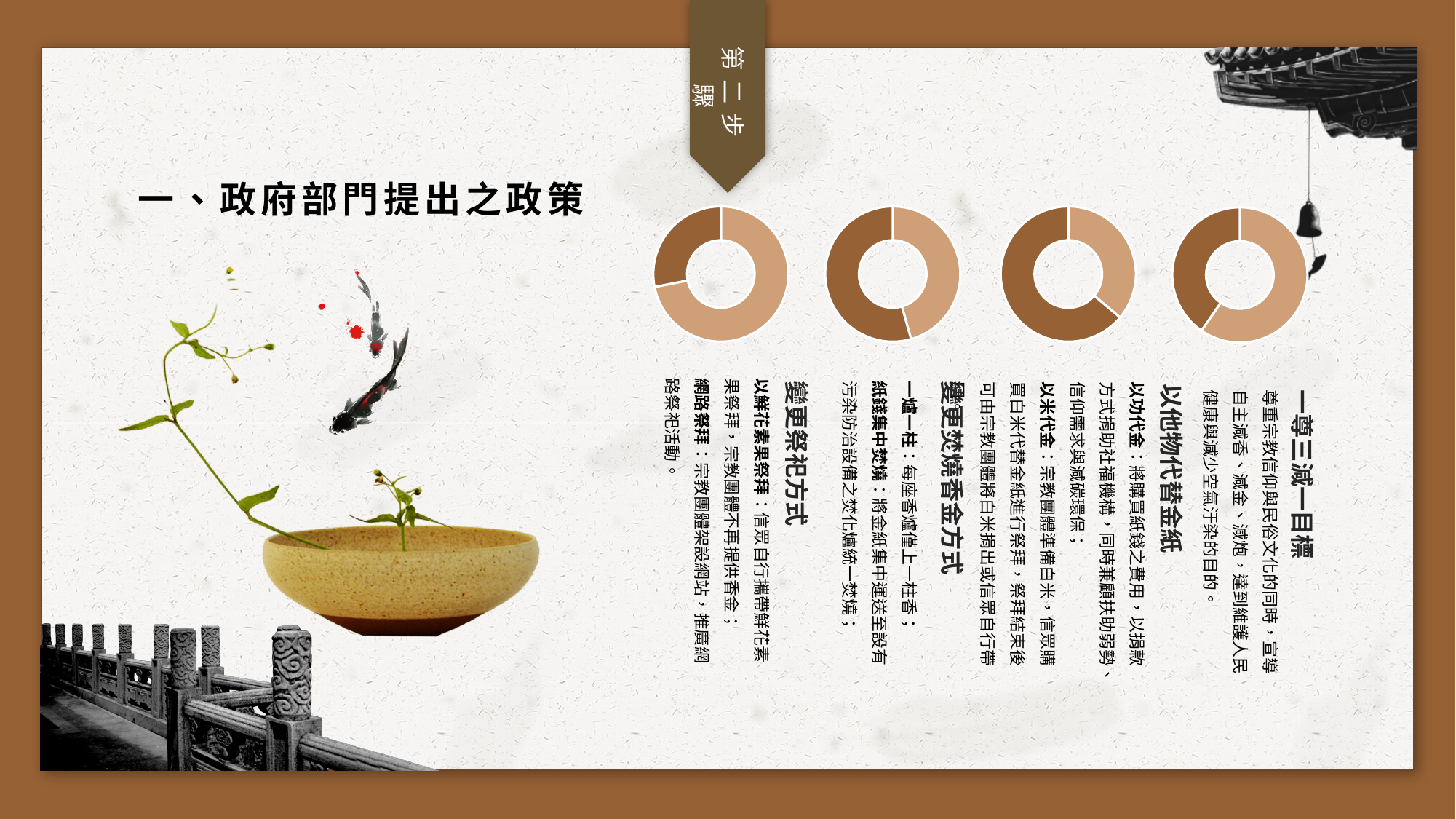
How many doughnut charts are shown on the slide? 4 Which of the four doughnut charts has the smallest dark brown slice? the leftmost chart In the third doughnut chart from the left, which slice is larger, the dark brown one or the light brown one? dark brown In the leftmost doughnut chart, which slice is larger, the dark brown one or the light brown one? light brown Do the doughnut charts on the slide display any data labels or a legend? No How many slices does the rightmost doughnut chart have? 2 What kind of chart is the leftmost chart on the slide? doughnut chart In the second doughnut chart from the left, which slice is larger, the dark brown one or the light brown one? dark brown Which of the four doughnut charts has the largest dark brown slice? the third chart from the left How many slices does the leftmost doughnut chart have? 2 What two colours are used for the slices in the doughnut charts? dark brown and light brown